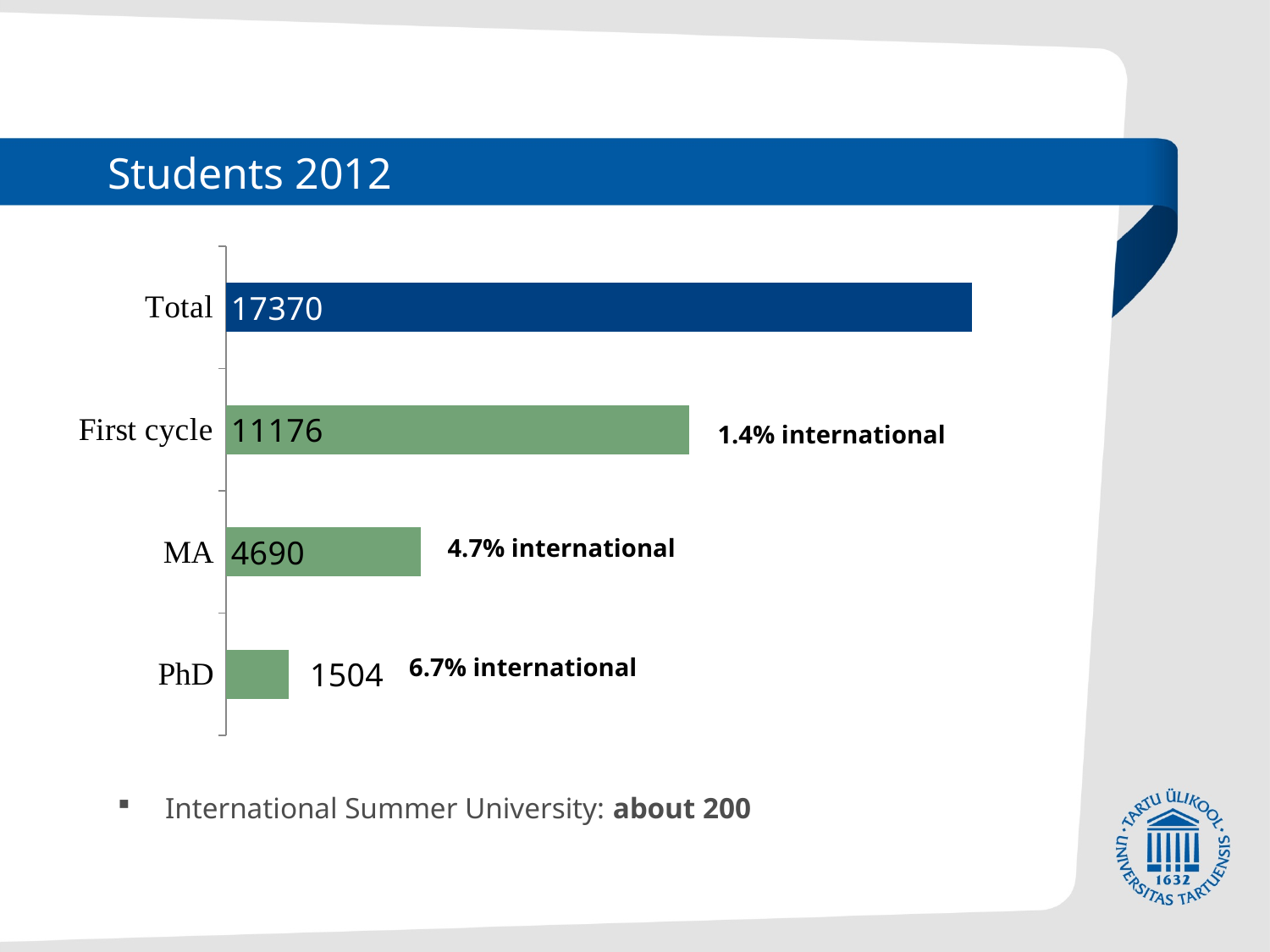
Which is larger, the value for MA or the value for PhD? MA What is the value for MA? 4690 Which category has the highest value? Total What is the value for First cycle? 11176 Which category has the lowest value? PhD What is the difference between the MA and PhD values? 3186 What is the value for PhD? 1504 What percentage of PhD students is labelled as international? 6.7% How many categories are shown in the chart? 4 What is the value for Total? 17370 What is the difference between the First cycle and MA values? 6486 What kind of chart is shown on the slide? bar chart